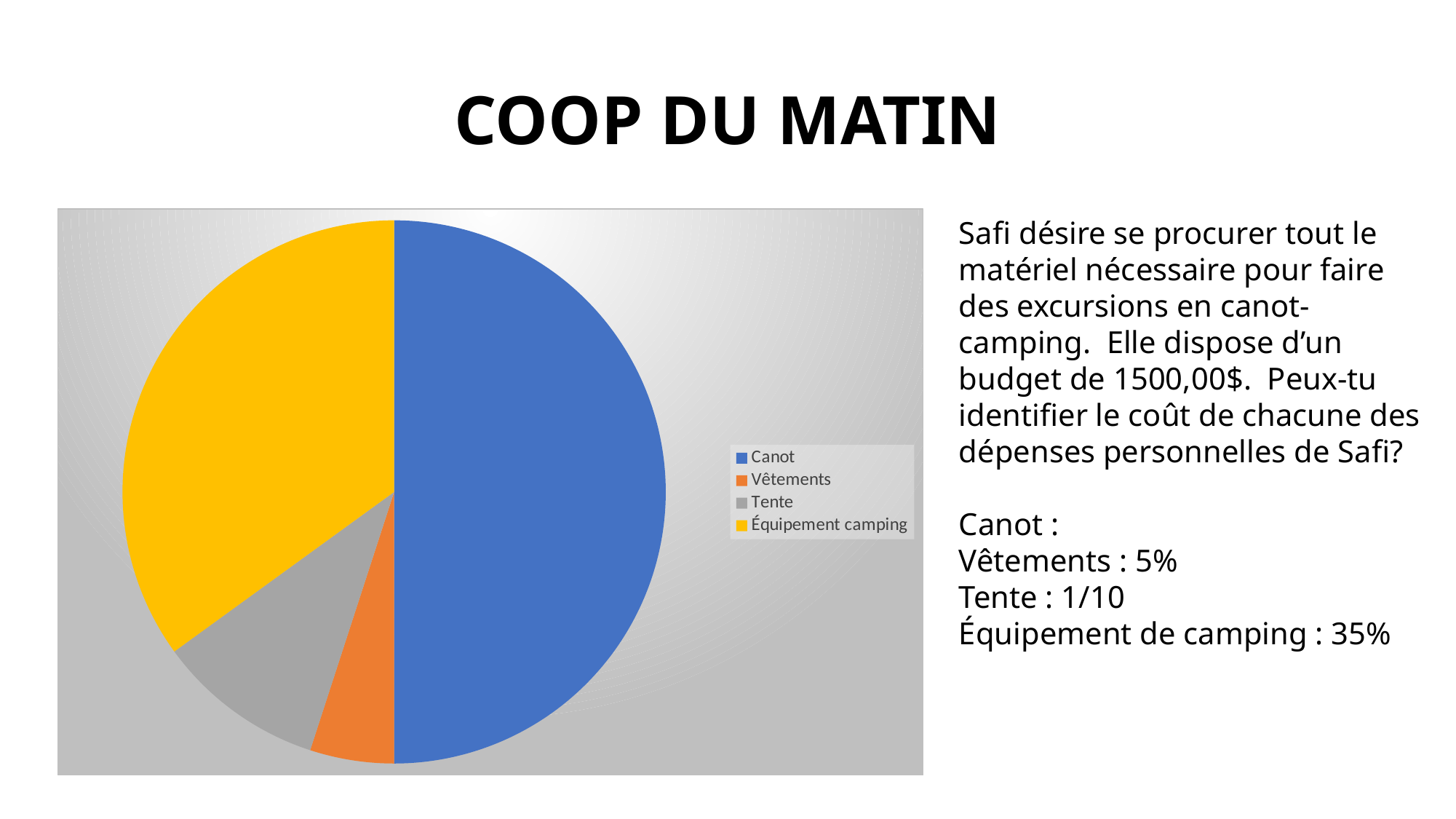
According to the slide, what share of the budget goes to Équipement de camping? 35% How many slices does the pie chart have? 4 Which category has the smallest slice of the pie chart? Vêtements According to the slide, what share of the budget goes to Tente? 1/10 According to the slide, what share of the budget goes to Vêtements? 5% What kind of chart is shown on the slide? pie chart Which slice is larger, Canot or Équipement camping? Canot Which slice is larger, Équipement camping or Tente? Équipement camping Which category has the largest slice of the pie chart? Canot How many entries does the legend of the pie chart list? 4 What colour is the Canot slice in the pie chart? blue Which slice is larger, Tente or Vêtements? Tente